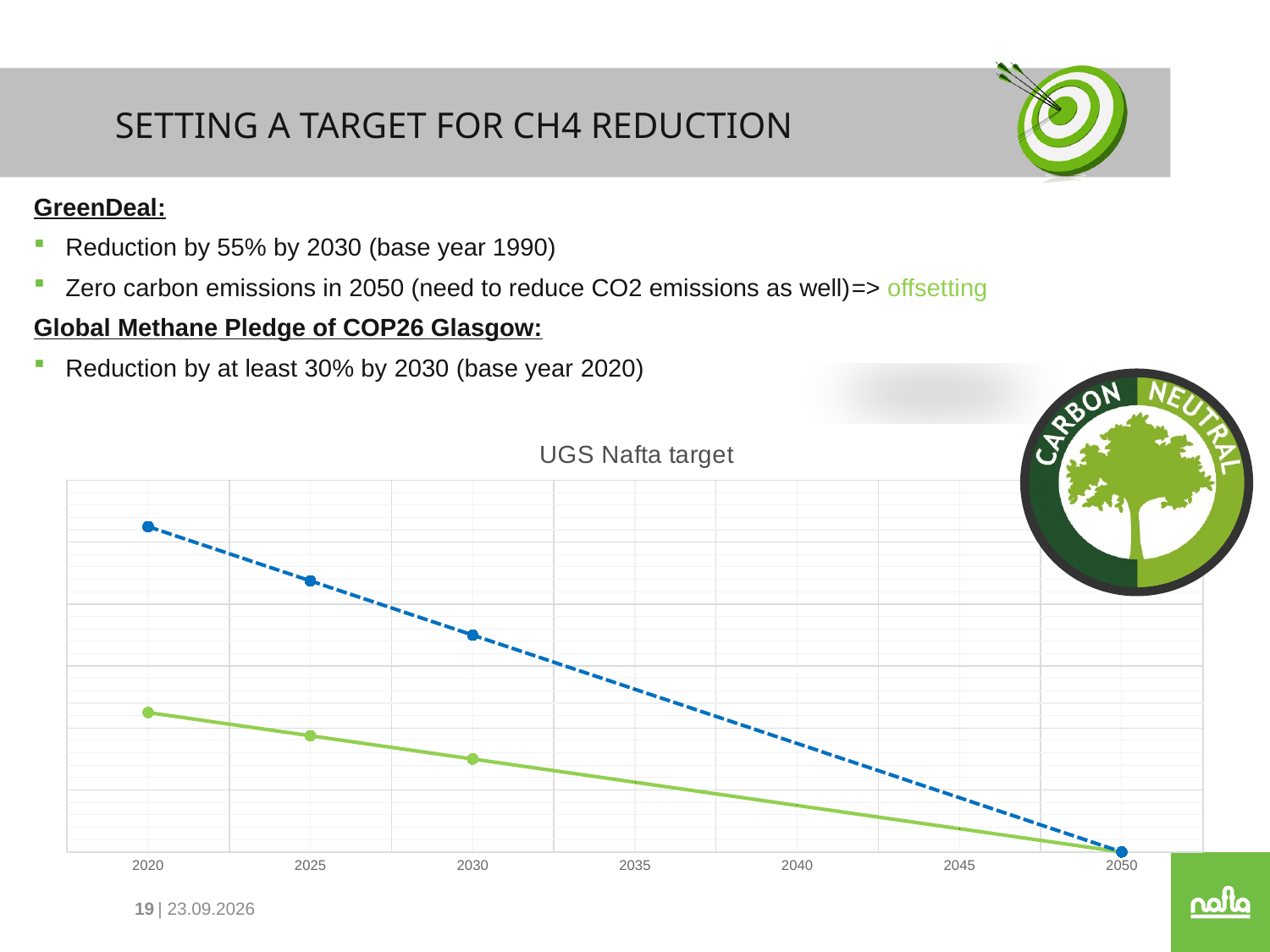
How many year labels are shown on the x axis of the "UGS Nafta target" chart? 7 What is the title of the chart on the slide? UGS Nafta target In the "UGS Nafta target" chart, which line is drawn dashed, the blue one or the green one? the blue one Do the values of the green solid line in the "UGS Nafta target" chart rise or fall from 2020 to 2050? fall Do the values of the blue dashed line in the "UGS Nafta target" chart rise or fall from 2020 to 2050? fall In the "UGS Nafta target" chart, in which year do the blue dashed line and the green solid line meet? 2050 In the "UGS Nafta target" chart, in which year does the blue dashed line reach its lowest point? 2050 How many lines are plotted in the "UGS Nafta target" chart? 2 What is the last year shown on the x axis of the "UGS Nafta target" chart? 2050 In the "UGS Nafta target" chart, which line is higher in 2020, the blue dashed line or the green solid line? the blue dashed line What kind of chart is shown under the title "UGS Nafta target"? line chart What is the first year shown on the x axis of the "UGS Nafta target" chart? 2020